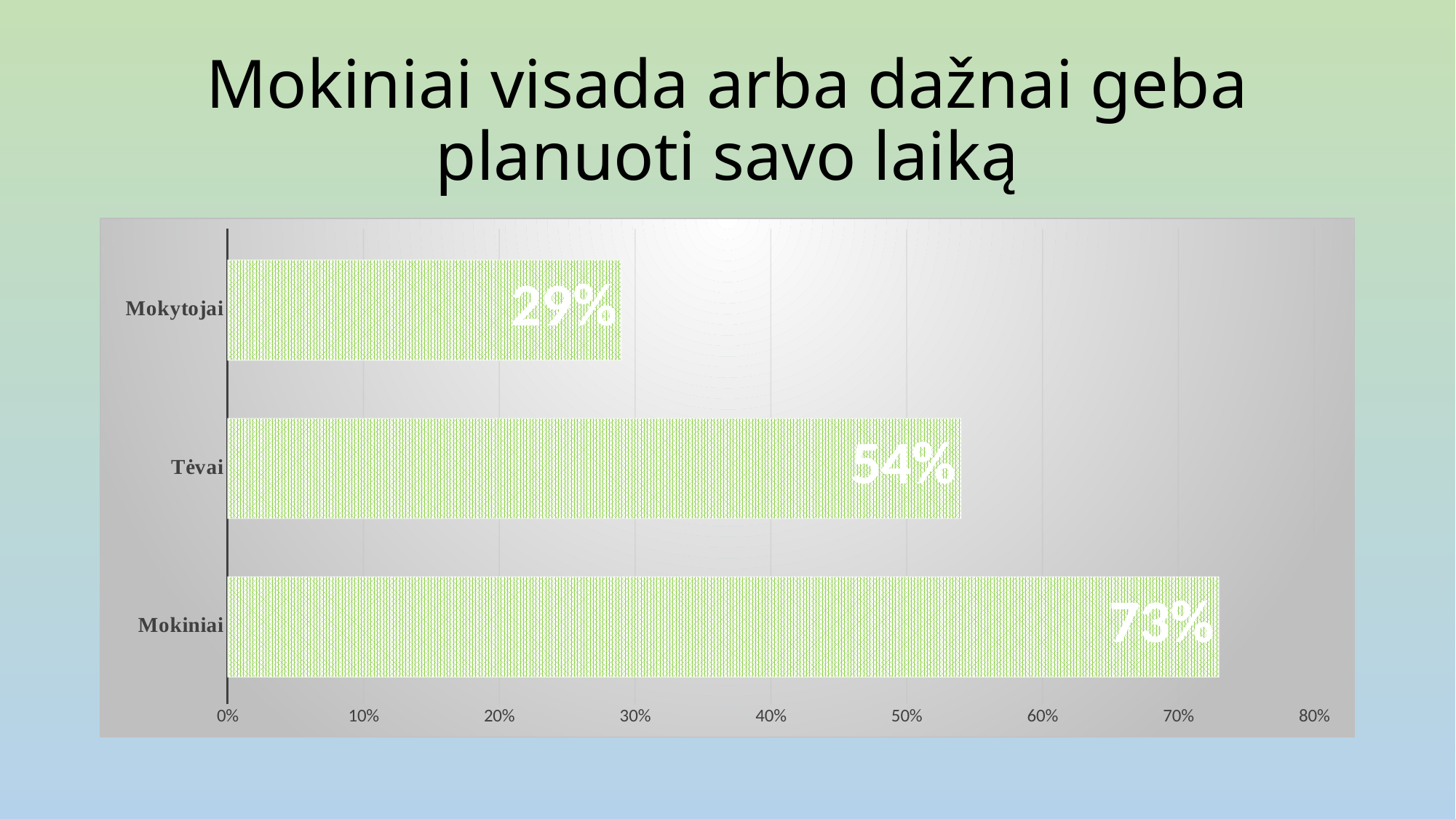
How many categories are shown in the chart? 3 Which category has the highest value? Mokiniai What is the difference between the values for Mokiniai and Mokytojai? 44% Which is larger, the value for Tėvai or the value for Mokytojai? Tėvai What is the value for Mokytojai? 29% What is the value for Tėvai? 54% What is the value for Mokiniai? 73% What is the difference between the values for Tėvai and Mokytojai? 25% What is the title of the slide? Mokiniai visada arba dažnai geba planuoti savo laiką Is the value for Tėvai greater or less than 50%? greater Which category has the lowest value? Mokytojai What kind of chart is shown on the slide? bar chart